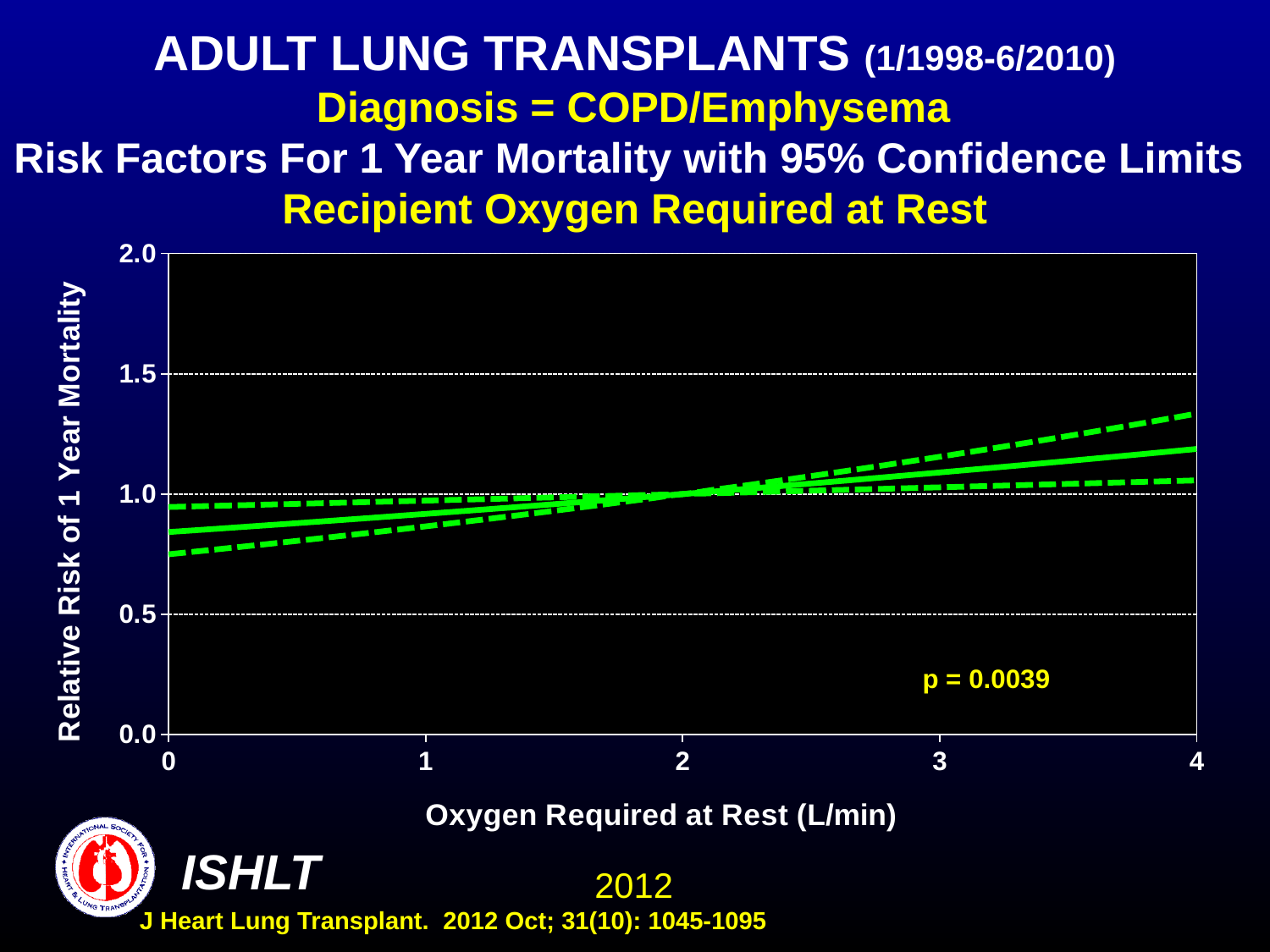
What kind of chart is shown on the slide? line chart What is the label of the x axis? Oxygen Required at Rest (L/min) What p-value is shown on the chart? p = 0.0039 Does the relative risk of 1 year mortality rise or fall as oxygen required at rest increases from 0 to 4 L/min? rise Is the lower 95% confidence limit at 0 L/min oxygen required at rest greater or less than 0.5? greater What is the highest value shown on the x axis? 4 Is the relative risk of 1 year mortality at 0 L/min oxygen required at rest greater or less than 1.0? less Is the relative risk of 1 year mortality higher at 4 L/min or at 0 L/min oxygen required at rest? 4 L/min What is the highest value shown on the y axis? 2.0 Is the upper 95% confidence limit at 4 L/min oxygen required at rest greater or less than 1.5? less How many lines are plotted on the chart? 3